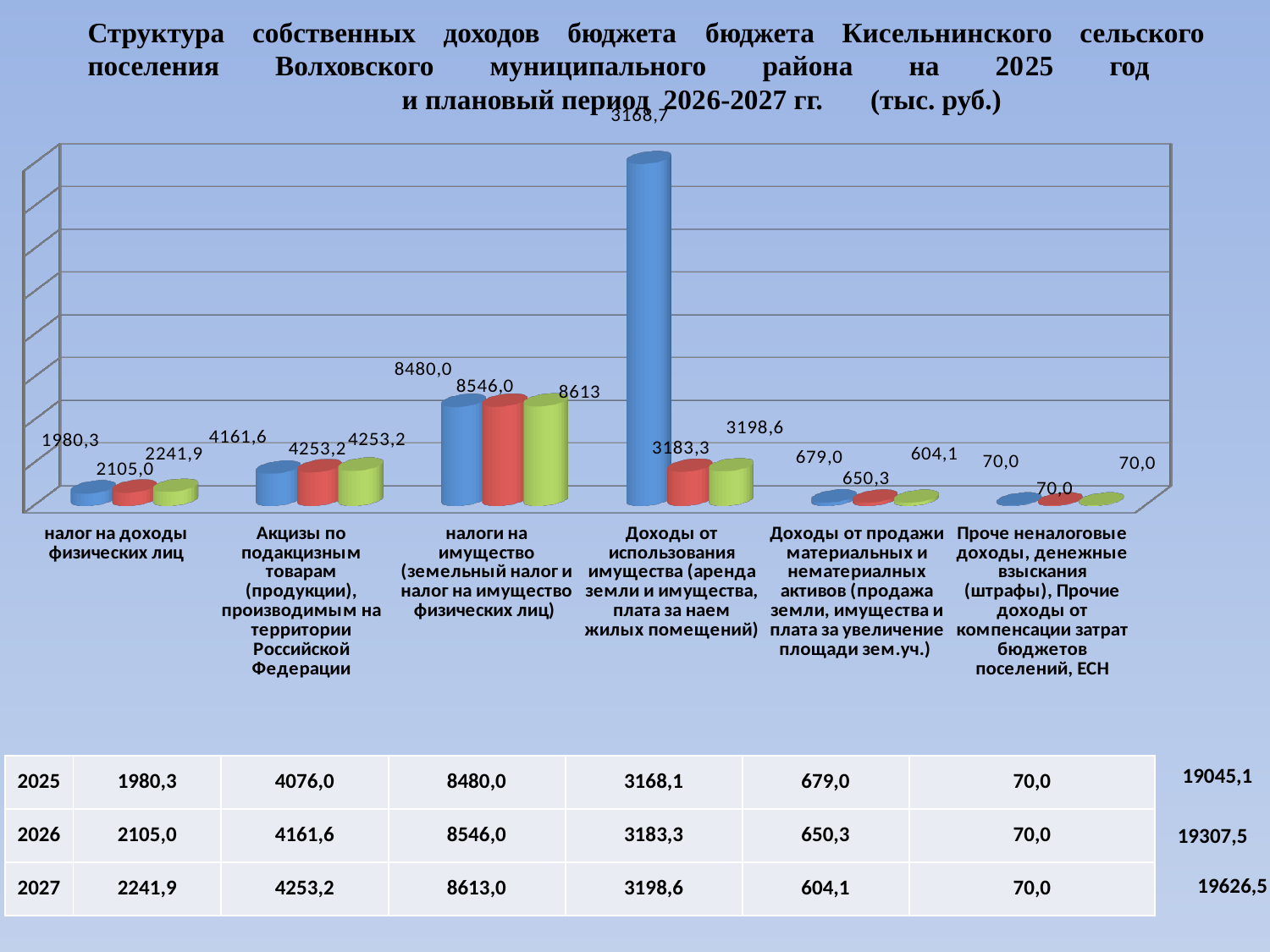
What is the 2026 (red bar) value for "налоги на имущество (земельный налог и налог на имущество физических лиц)"? 8546,0 What is the 2025 (blue bar) value for "Прочие неналоговые доходы, денежные взыскания (штрафы)..."? 70,0 Among the three bars for "Доходы от продажи материальных и нематериальных активов...", which year has the lowest value? 2027 How many income categories are shown along the x axis of the chart? 6 For "Доходы от продажи материальных и нематериальных активов...", which is larger: the 2025 value or the 2026 value? 2025 (679,0) Do the values for "налоги на имущество" rise or fall from 2025 to 2027? rise What kind of chart is shown on the slide? bar chart What is the difference between the 2026 and 2025 values for "налог на доходы физических лиц"? 124,7 What is the difference between the 2026 and 2025 values for "налоги на имущество"? 66,0 Among the three bars for "налог на доходы физических лиц", which year has the highest value? 2027 What is the 2027 (green bar) value for "налог на доходы физических лиц"? 2241,9 How many bars are plotted for each income category? 3